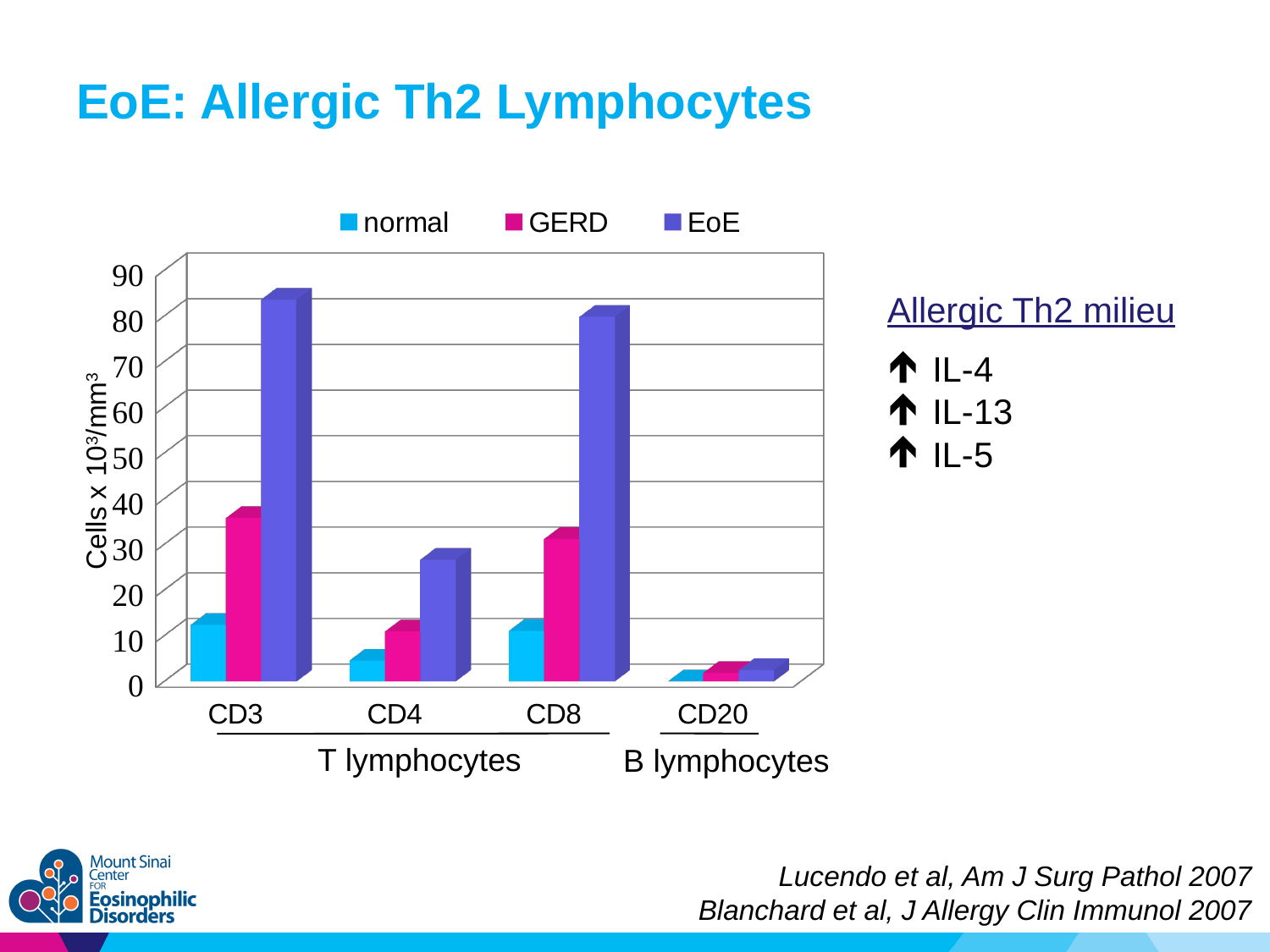
Which series is shown in magenta in the legend? GERD Which category has the lowest EoE value? CD20 How many categories are shown on the x axis? 4 Is the GERD value for CD3 greater or less than 40? less What kind of chart is shown on the slide? bar chart How many series does the legend list? 3 What is the label of the y axis? Cells x 10³/mm³ For CD8, which series has the larger value, GERD or EoE? EoE Is the normal value for CD8 greater or less than 20? less Which category has the highest EoE value? CD3 Is the EoE value for CD3 greater or less than 80? greater